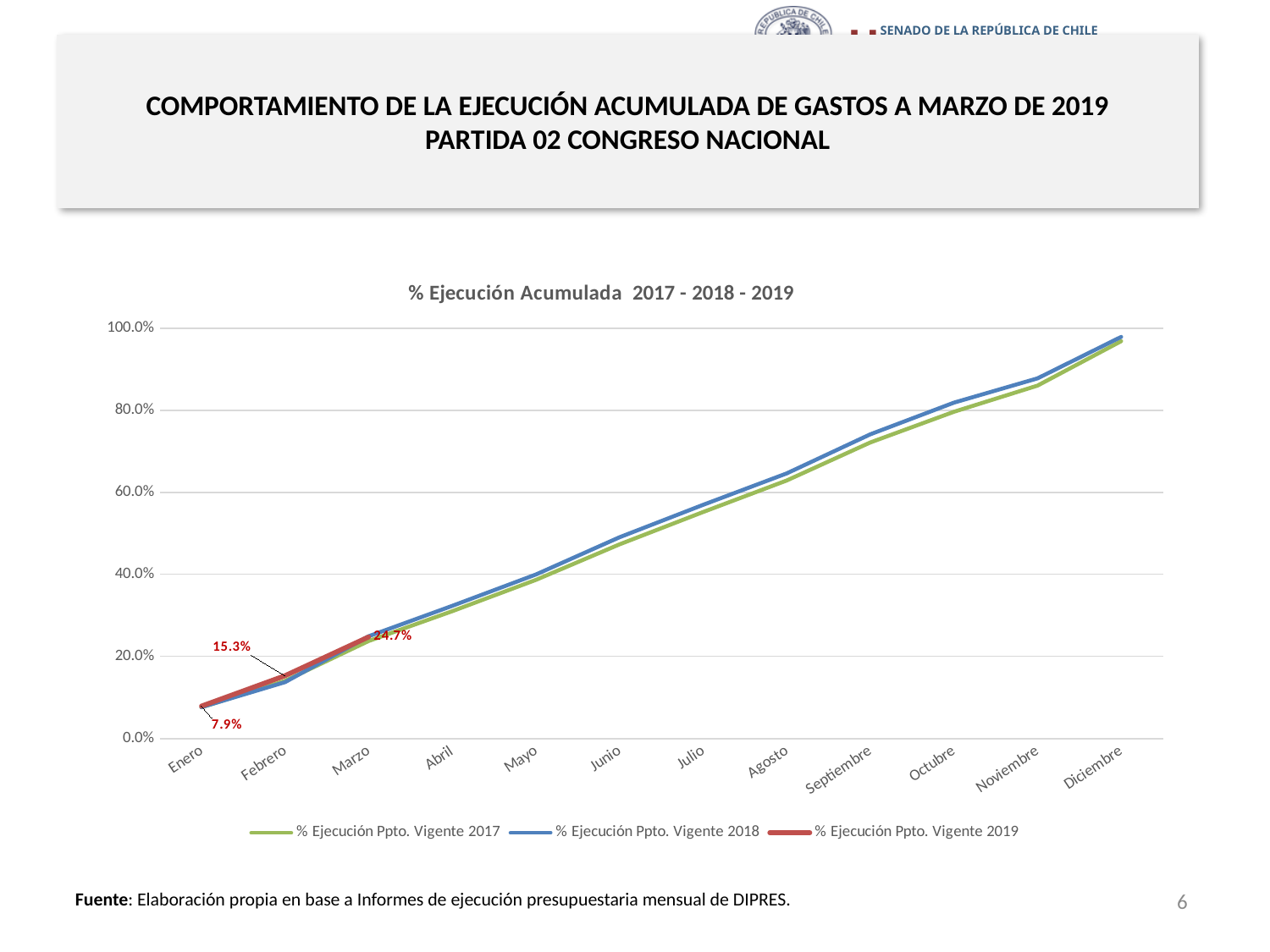
What is the title of the chart? % Ejecución Acumulada 2017 - 2018 - 2019 What is the value for % Ejecución Ppto. Vigente 2019 in Enero? 7.9% Do the values for % Ejecución Ppto. Vigente 2018 rise or fall from Enero to Diciembre? Rise By how much did % Ejecución Ppto. Vigente 2019 increase from Febrero to Marzo? 9.4% How many series does the legend list? 3 What kind of chart is shown on the slide? Line chart Is the value for % Ejecución Ppto. Vigente 2017 in Junio greater or less than 60.0%? less Is the value for % Ejecución Ppto. Vigente 2018 in Diciembre greater or less than 80.0%? greater How many months are shown on the x axis? 12 What is the value for % Ejecución Ppto. Vigente 2019 in Marzo? 24.7% What is the value for % Ejecución Ppto. Vigente 2019 in Febrero? 15.3% What is the difference between the 2019 values for Febrero and Enero? 7.4%